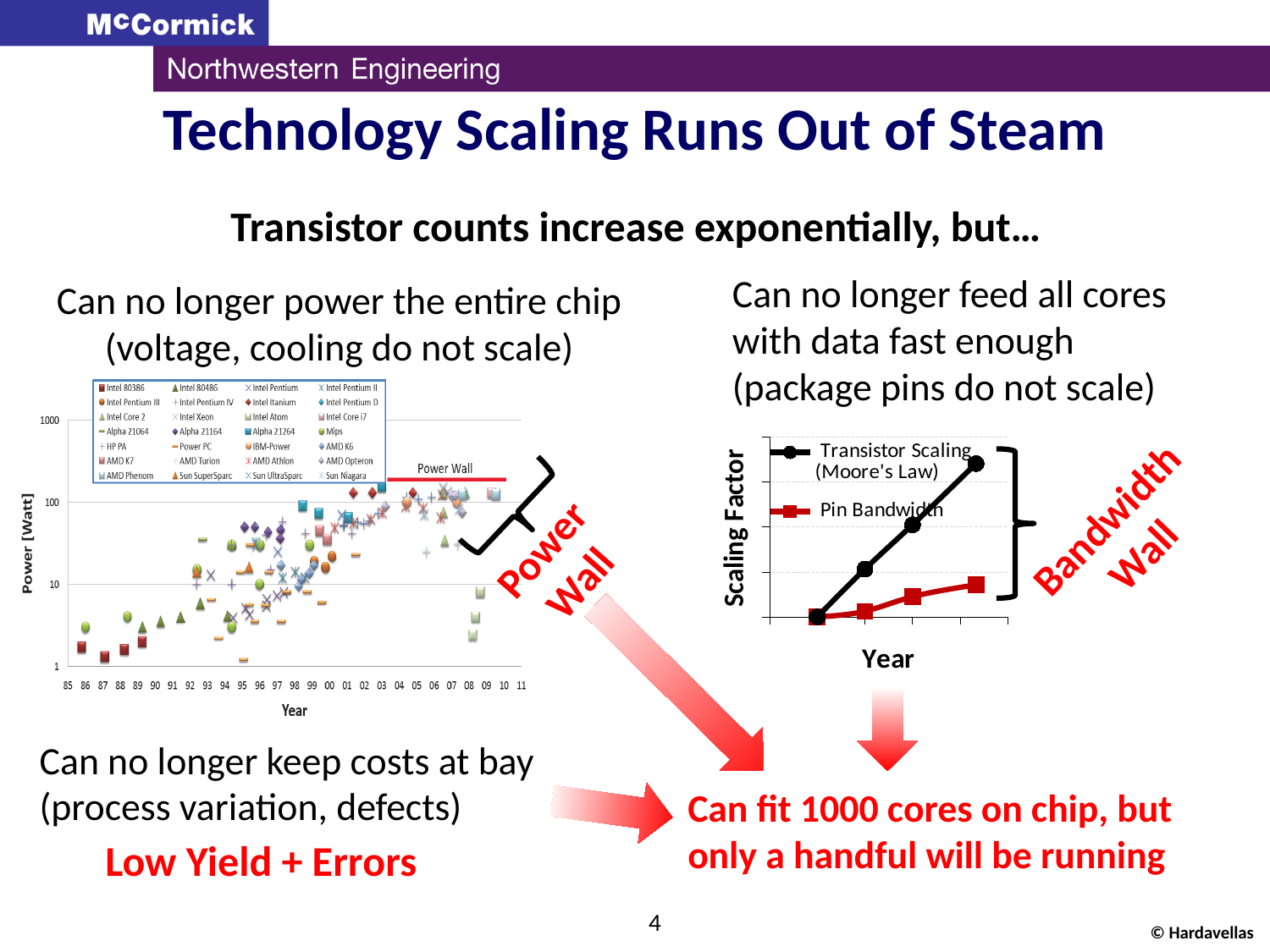
In the right chart (Scaling Factor vs Year), how many series does the legend list? 2 In the left chart (Power [Watt] vs Year), what is the label of the red horizontal line near the top right? Power Wall In the right chart (Scaling Factor vs Year), does the Transistor Scaling (Moore's Law) series rise or fall along the x axis? Rise In the right chart (Scaling Factor vs Year), which series has the steeper increase? Transistor Scaling (Moore's Law) What kind of chart is the left chart plotting Power [Watt] against Year? Scatter plot In the left chart (Power [Watt] vs Year), what is the highest value shown on the y axis? 1000 What kind of chart is the right chart plotting Scaling Factor against Year? Line chart In the right chart (Scaling Factor vs Year), how many data points does the Transistor Scaling (Moore's Law) series have? 4 In the right chart (Scaling Factor vs Year), what are the two series named in the legend? Transistor Scaling (Moore's Law) and Pin Bandwidth What is the y-axis label of the left chart (Power vs Year)? Power [Watt] In the left chart (Power [Watt] vs Year), do the plotted power values generally rise or fall from 85 to 11 along the x axis? Rise In the right chart (Scaling Factor vs Year), which series is higher at the last year shown: Transistor Scaling (Moore's Law) or Pin Bandwidth? Transistor Scaling (Moore's Law)